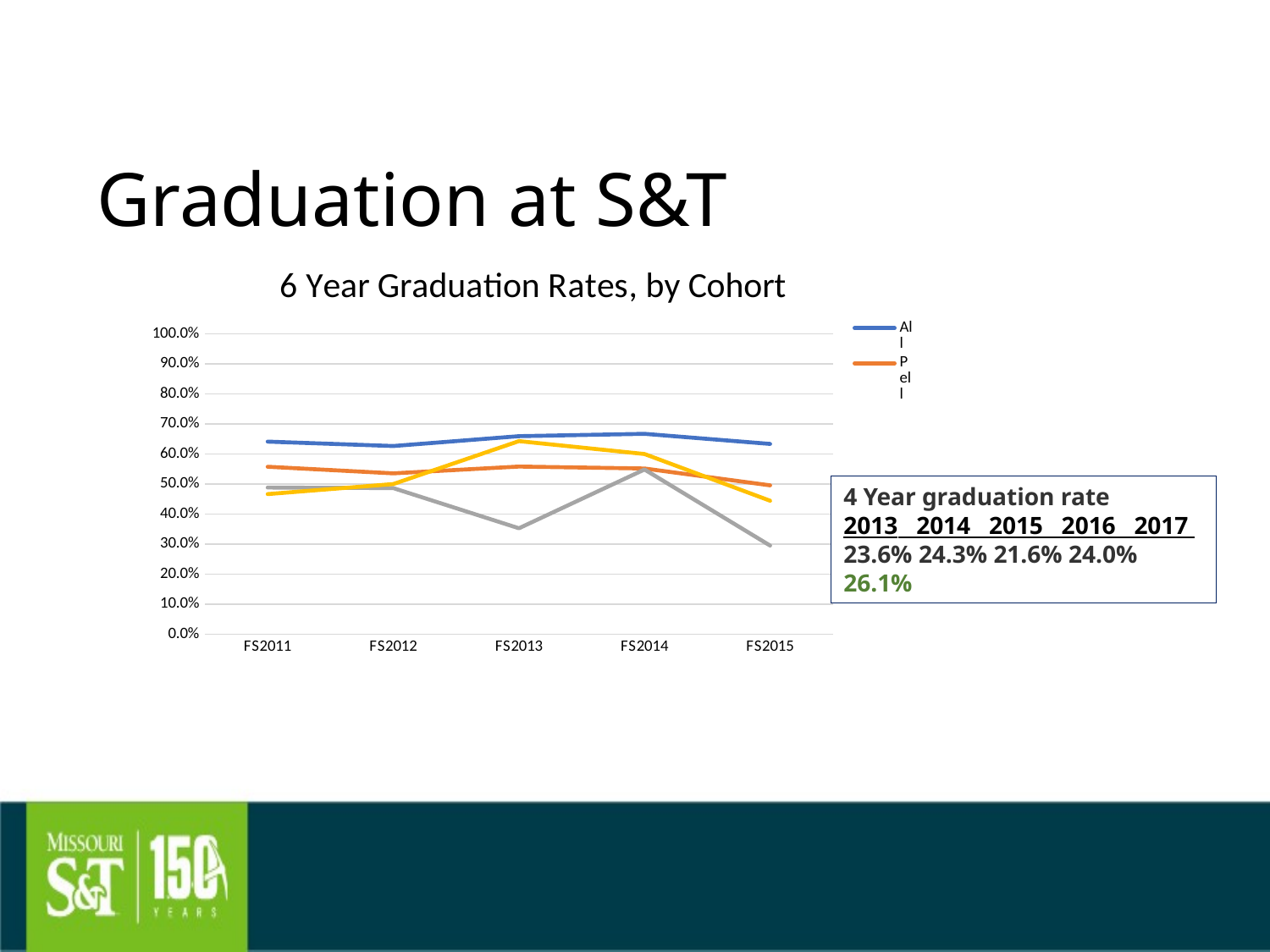
Does the Pell series rise or fall from FS2014 to FS2015? fall How many cohorts are shown along the x axis of the chart? 5 Is the value for All in the FS2011 cohort greater or less than 60.0%? greater What kind of chart is shown on the slide? line chart Is the value for Pell in the FS2013 cohort greater or less than 60.0%? less Is the value for Pell in the FS2011 cohort greater or less than 50.0%? greater Which cohort has the lowest value for the Pell series? FS2015 Which cohort is the first one on the x axis of the chart? FS2011 In the FS2015 cohort, which series has the higher value, All or Pell? All What is the title of the chart? 6 Year Graduation Rates, by Cohort In the FS2011 cohort, which series has the higher value, All or Pell? All